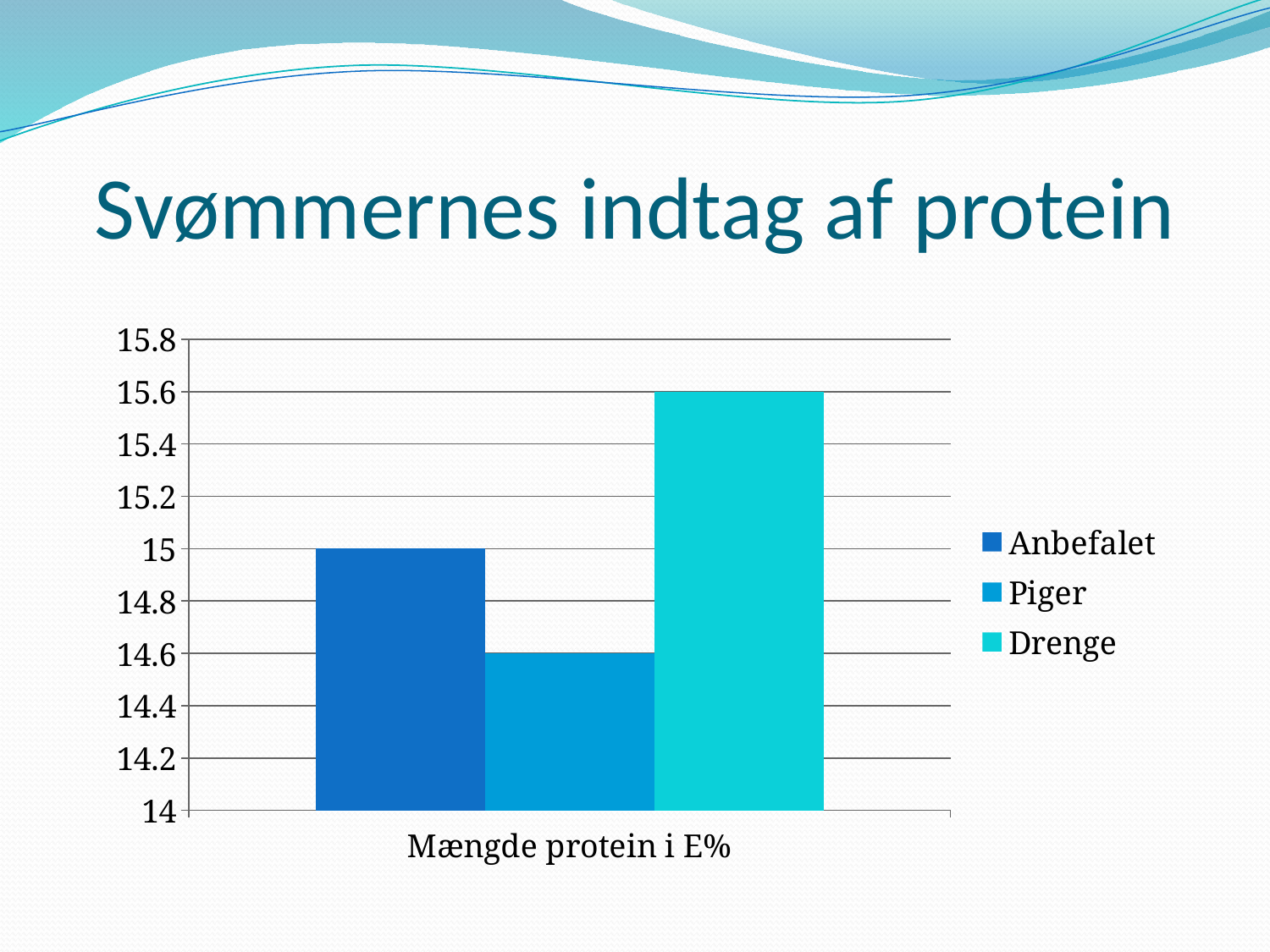
What is the value for Drenge? 15.6 Which is larger, the value for Drenge or the value for Anbefalet? Drenge Which series has the lowest value? Piger What is the value for Piger? 14.6 What is the difference between the values for Drenge and Piger? 1 What is the difference between the values for Anbefalet and Piger? 0.4 What is the label on the x axis of the chart? Mængde protein i E% What kind of chart is shown on the slide? bar chart Is the value for Piger greater or less than 15? less What is the value for Anbefalet? 15 Which series has the highest value? Drenge How many series does the legend list? 3